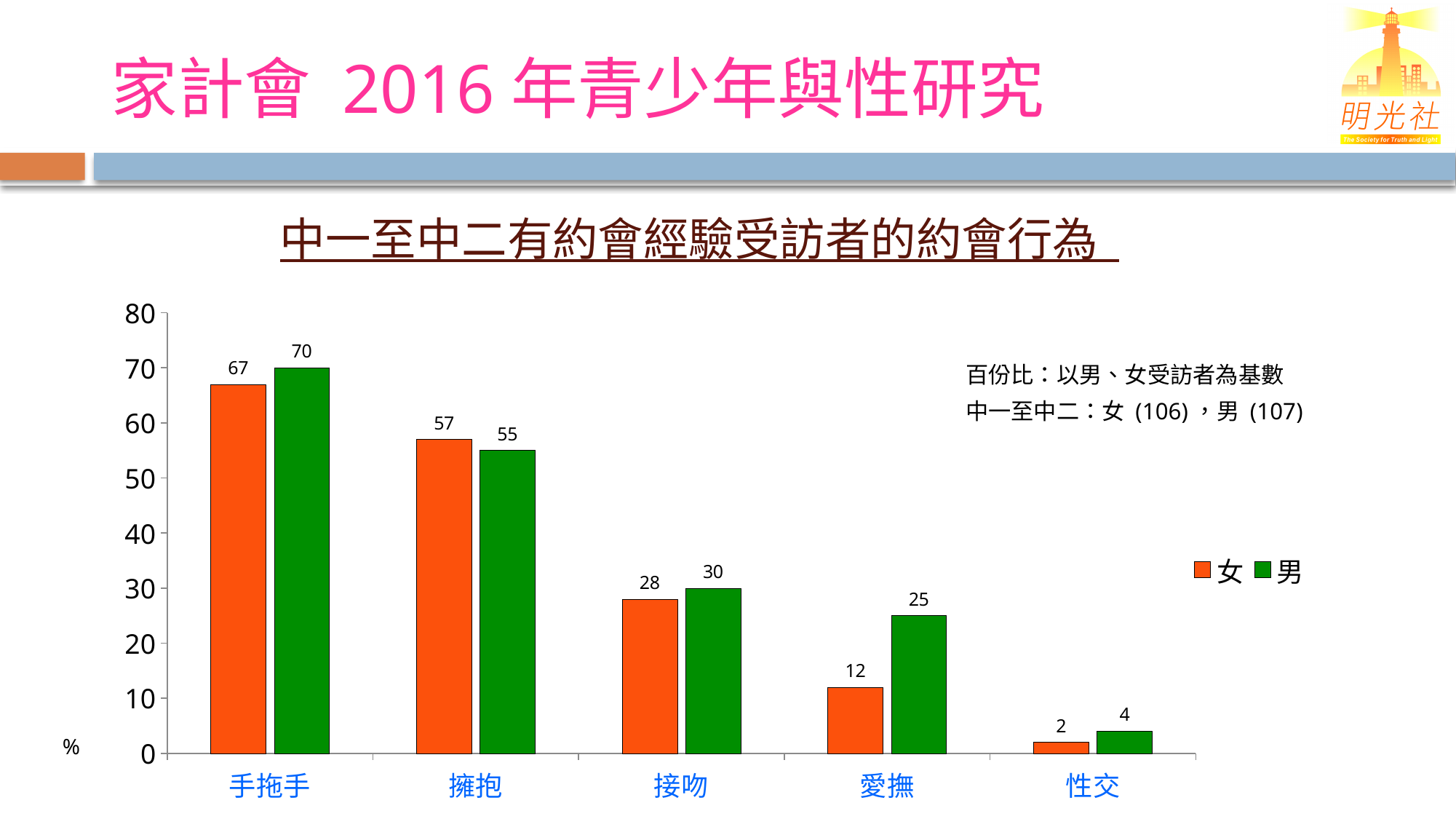
What is the value for 女 in the 性交 category? 2 What is the value for 男 in the 愛撫 category? 25 How many categories are shown on the x axis? 5 Which category has the highest value for 男? 手拖手 What kind of chart is shown on the slide? bar chart What is the value for 女 in the 手拖手 category? 67 Which category has the lowest value for 女? 性交 Do the values for 女 rise or fall from 手拖手 to 性交 along the x axis? fall What is the difference between the 男 and 女 values in the 愛撫 category? 13 In the 擁抱 category, which series has the larger value, 女 or 男? 女 How many series does the legend list? 2 Is the value for 男 in the 接吻 category greater or less than 20? greater